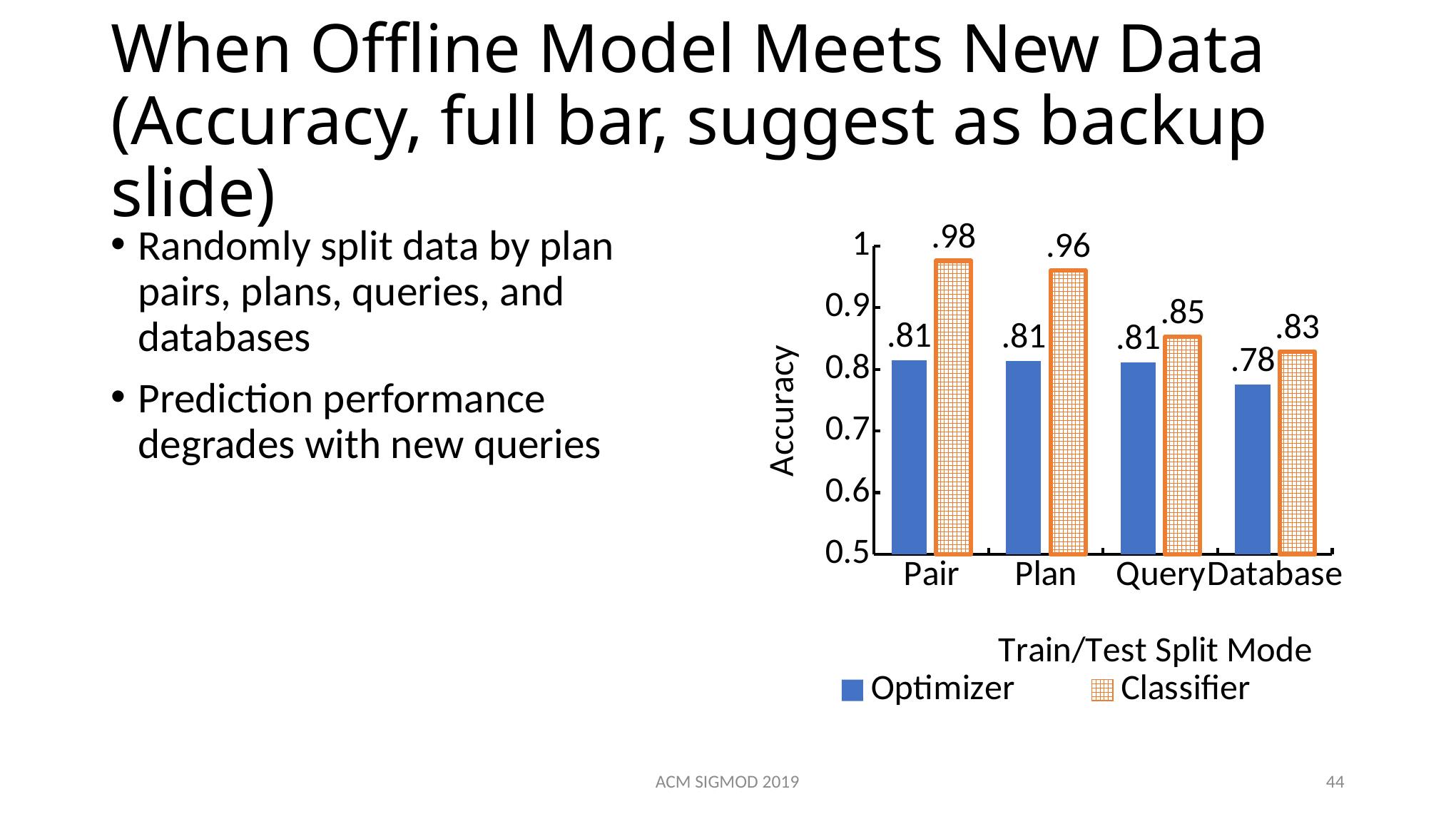
Which split mode has the lowest Optimizer accuracy? Database Is the Classifier accuracy for the Plan split mode greater or less than 0.9? greater What is the difference between the Classifier and Optimizer accuracy for the Plan split mode? .15 What is the Optimizer accuracy for the Database split mode? .78 What is the label of the y axis? Accuracy Which is larger for the Database split mode, the Optimizer accuracy or the Classifier accuracy? Classifier What kind of chart is shown on the slide? bar chart What is the Classifier accuracy for the Query split mode? .85 How many series does the legend list? 2 How many split modes are shown on the x axis? 4 Which split mode has the highest Classifier accuracy? Pair What is the Classifier accuracy for the Pair split mode? .98